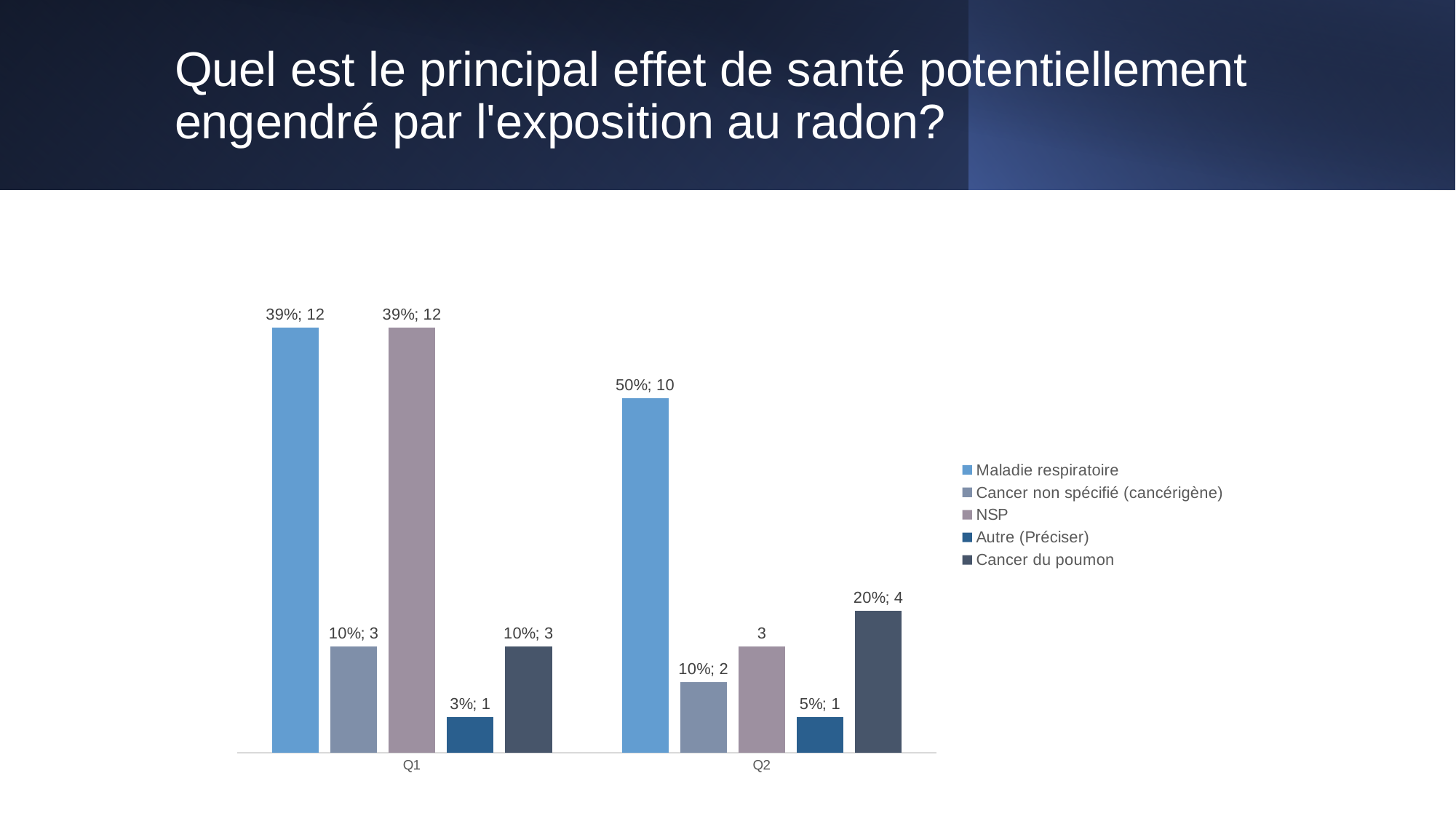
What is the data label for Autre (Préciser) in Q1? 3%; 1 What is the data label for NSP in Q2? 3 What is the data label for Cancer du poumon in Q2? 20%; 4 What is the difference in count between Maladie respiratoire and Cancer du poumon in Q2? 6 What is the data label for Maladie respiratoire in Q1? 39%; 12 How many categories are shown on the x axis? 2 In Q1, which is larger: the count for Cancer du poumon or the count for Autre (Préciser)? Cancer du poumon Which series has the highest value in Q2? Maladie respiratoire What is the data label for Maladie respiratoire in Q2? 50%; 10 Which series has the lowest value in Q2? Autre (Préciser) How many series does the legend list? 5 What kind of chart is shown on the slide? bar chart